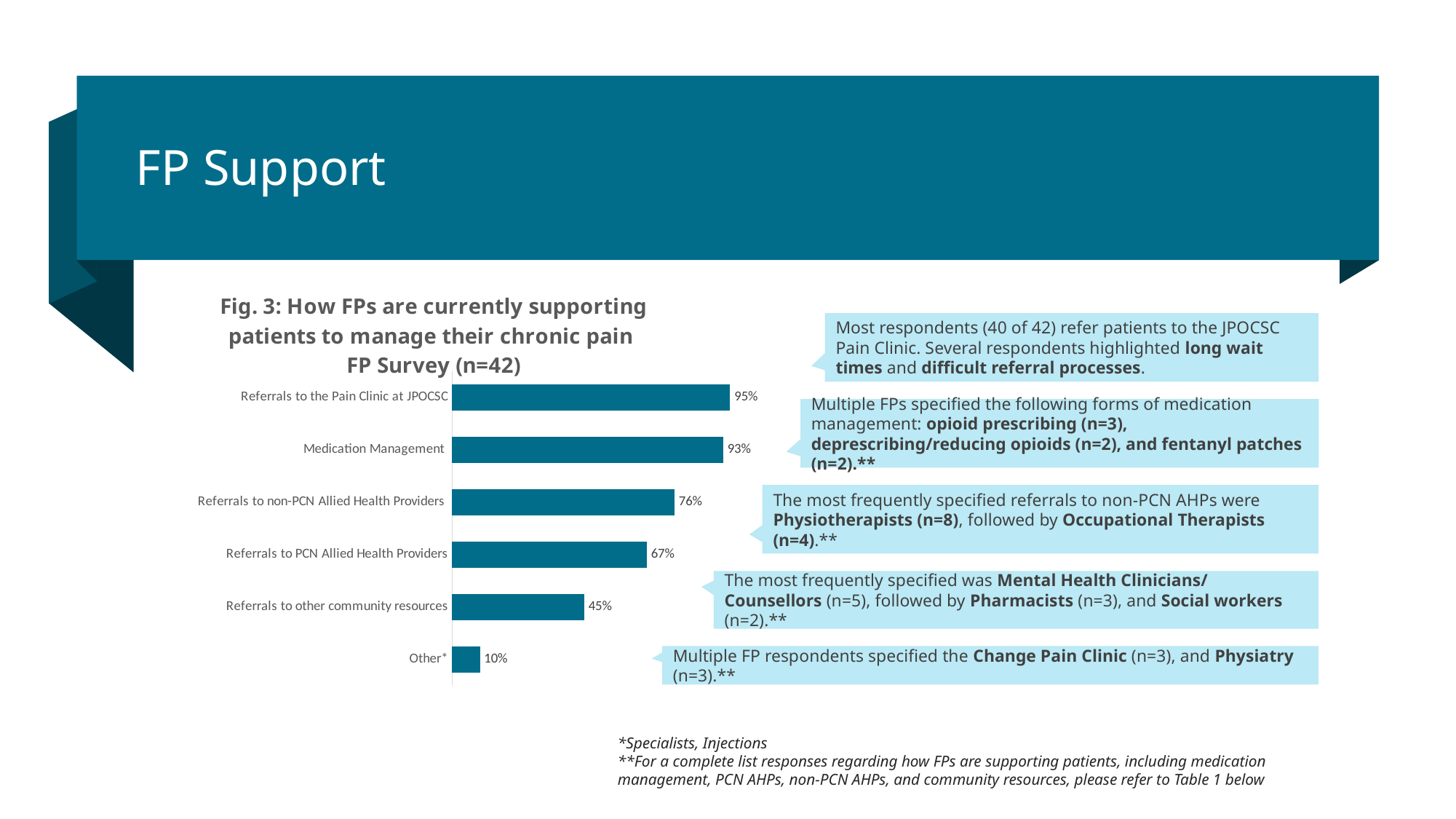
Which category has the lowest value in the chart? Other* What is the difference between Referrals to non-PCN Allied Health Providers and Referrals to PCN Allied Health Providers? 9% What kind of chart is shown on the slide? Bar chart Which is larger: Referrals to PCN Allied Health Providers or Referrals to other community resources? Referrals to PCN Allied Health Providers What is the value for Referrals to other community resources? 45% How many categories are shown in the chart? 6 What is the sample size (n) stated in the chart title? n=42 What percentage of FPs reported referrals to the Pain Clinic at JPOCSC? 95% What is the difference between the values for Referrals to the Pain Clinic at JPOCSC and Other*? 85% What percentage is shown for Referrals to non-PCN Allied Health Providers? 76% What is the value shown for Medication Management? 93% Which category has the highest value in the chart? Referrals to the Pain Clinic at JPOCSC